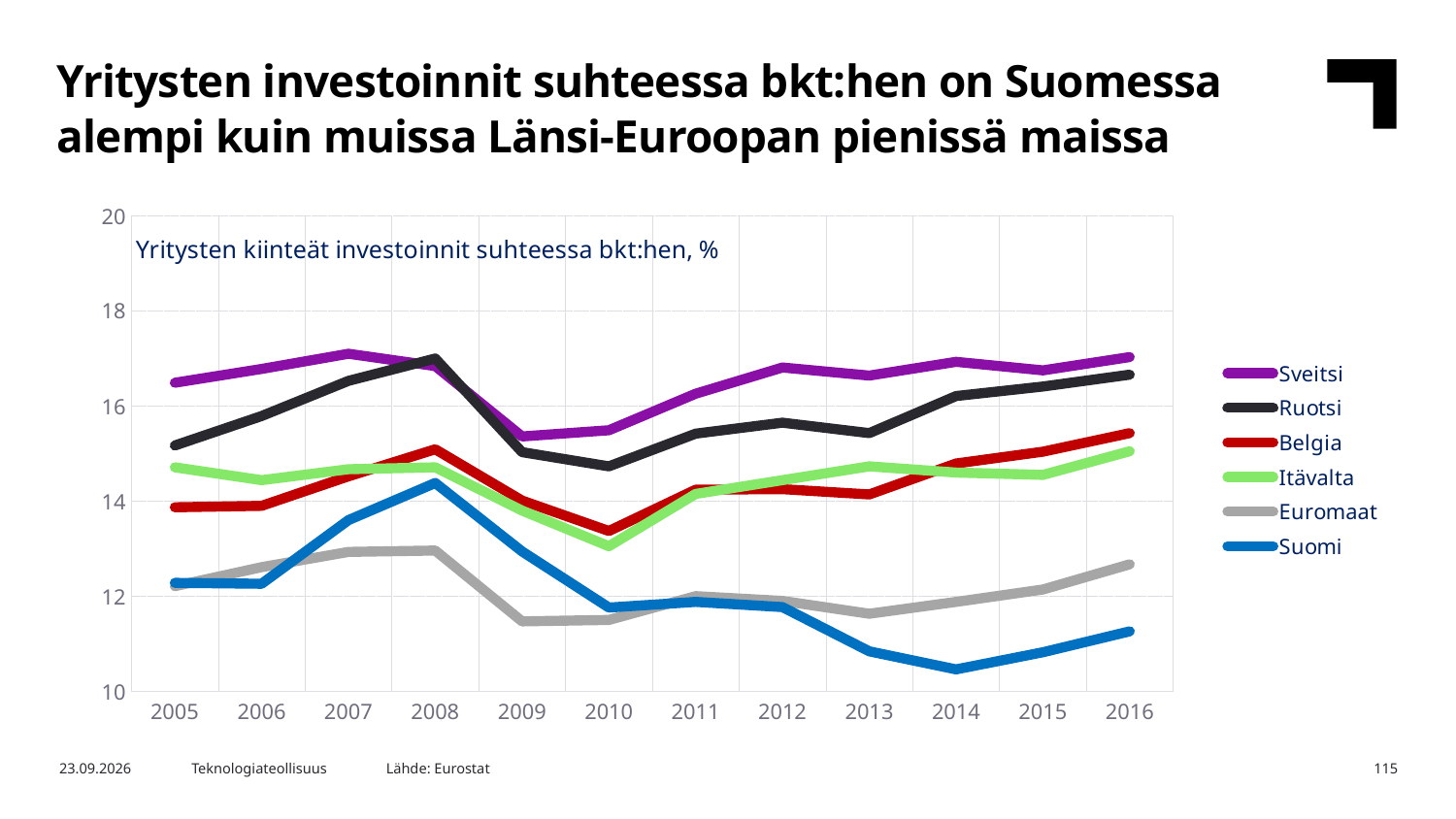
What kind of chart is shown on the slide? line chart In 2008, which is larger: Suomi or Euromaat? Suomi Which series has the highest value in 2012? Sveitsi In 2014, which is larger: Suomi or Euromaat? Euromaat Is the value for Euromaat in 2009 greater or less than 12? less Is the value for Sveitsi in 2007 greater or less than 16? greater Is the value for Suomi in 2014 greater or less than 12? less Does the value for Suomi rise or fall from 2008 to 2014? fall How many years are shown on the x axis? 12 In which year does Suomi reach its lowest value? 2014 How many series does the legend list? 6 Which country has the lowest value in 2016? Suomi